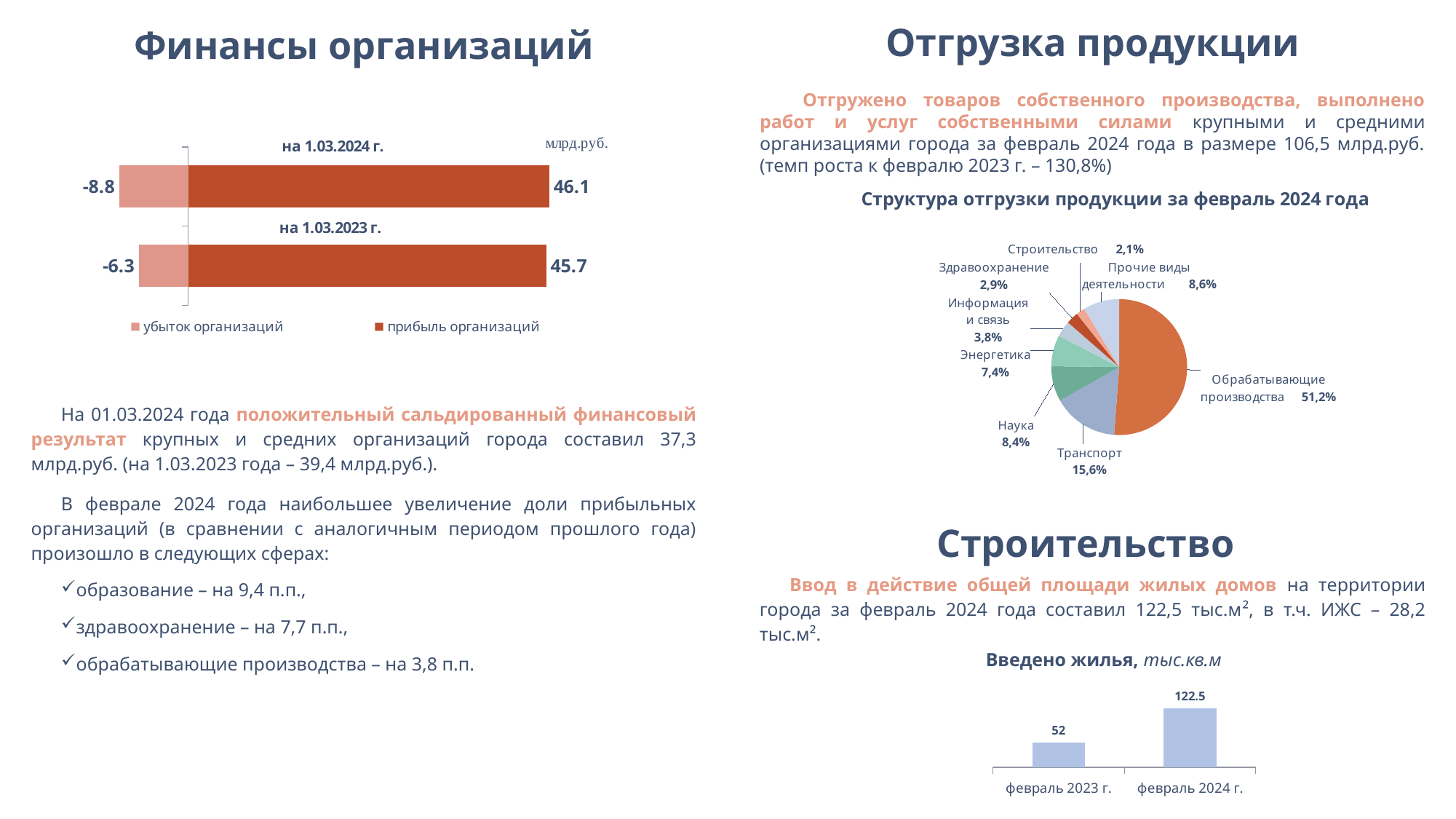
In the pie chart 'Структура отгрузки продукции за февраль 2024 года', which is larger: 'Наука' or 'Энергетика'? Наука In the pie chart 'Структура отгрузки продукции за февраль 2024 года', which category has the smallest share? Строительство In the 'Финансы организаций' bar chart, what is the value of 'убыток организаций' на 1.03.2023 г.? -6.3 In the 'Введено жилья, тыс.кв.м' bar chart, what is the difference between февраль 2024 г. and февраль 2023 г.? 70.5 In the 'Финансы организаций' bar chart, by how much did 'прибыль организаций' на 1.03.2024 г. exceed the value на 1.03.2023 г.? 0.4 In the 'Финансы организаций' bar chart, what is the value of 'прибыль организаций' на 1.03.2024 г.? 46.1 What type of chart is used for 'Финансы организаций'? bar chart How many series does the legend of the 'Финансы организаций' bar chart list? 2 In the 'Введено жилья, тыс.кв.м' bar chart, what is the value for февраль 2024 г.? 122.5 In the pie chart 'Структура отгрузки продукции за февраль 2024 года', what is the share of 'Транспорт'? 15,6% In the pie chart 'Структура отгрузки продукции за февраль 2024 года', what share does 'Обрабатывающие производства' have? 51,2% How many categories are shown in the pie chart 'Структура отгрузки продукции за февраль 2024 года'? 8